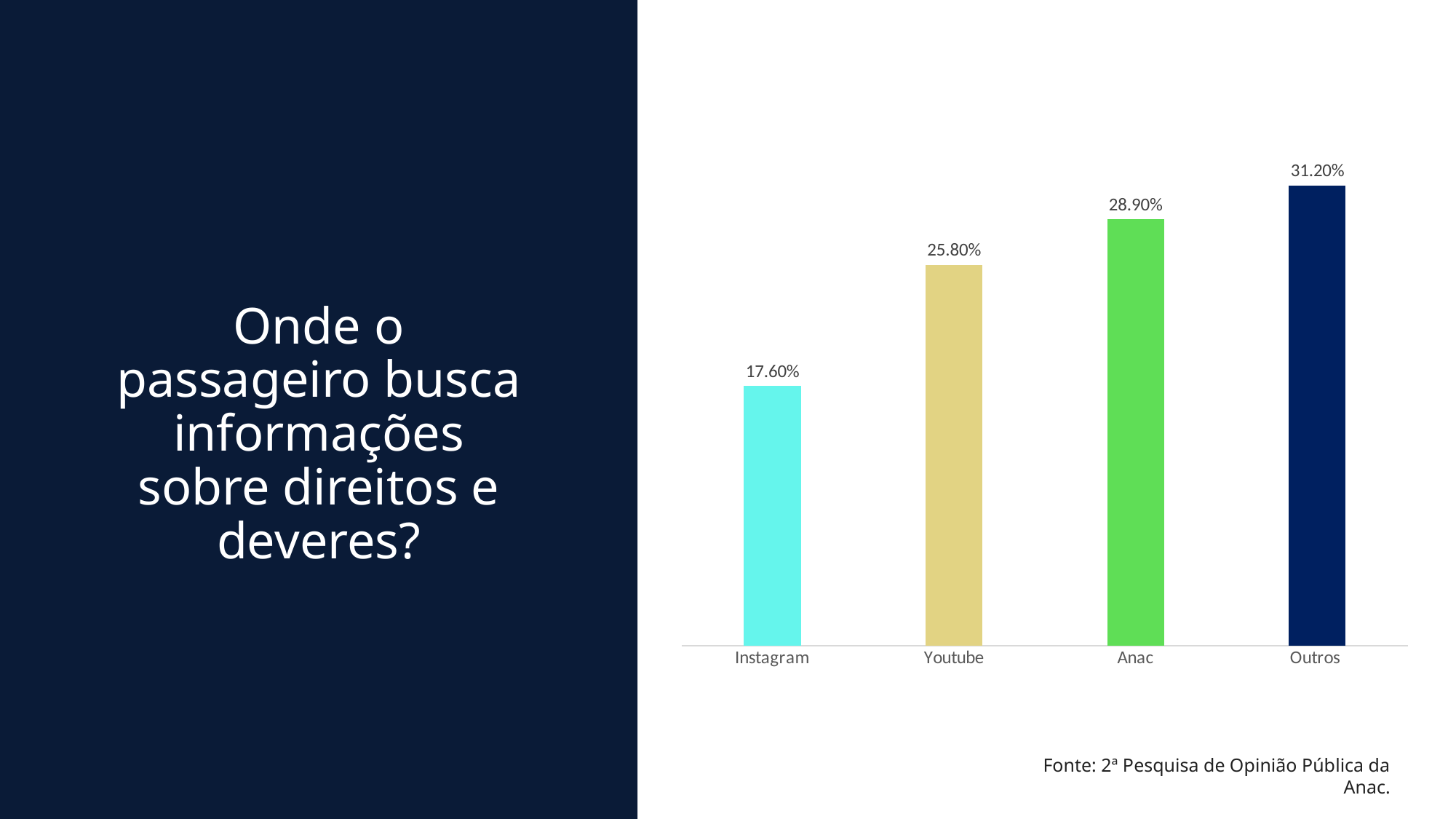
What is the value for Instagram? 17.60% What kind of chart is shown on the slide? Bar chart Do the values rise or fall from left to right along the x axis? Rise Which is larger, the value for Youtube or the value for Anac? Anac What is the value for Youtube? 25.80% Which category has the lowest value? Instagram What is the difference between the values for Outros and Instagram? 13.60% What is the difference between the values for Anac and Youtube? 3.10% What is the value for Outros? 31.20% How many categories are shown in the chart? 4 Which category has the highest value? Outros What is the value for Anac? 28.90%